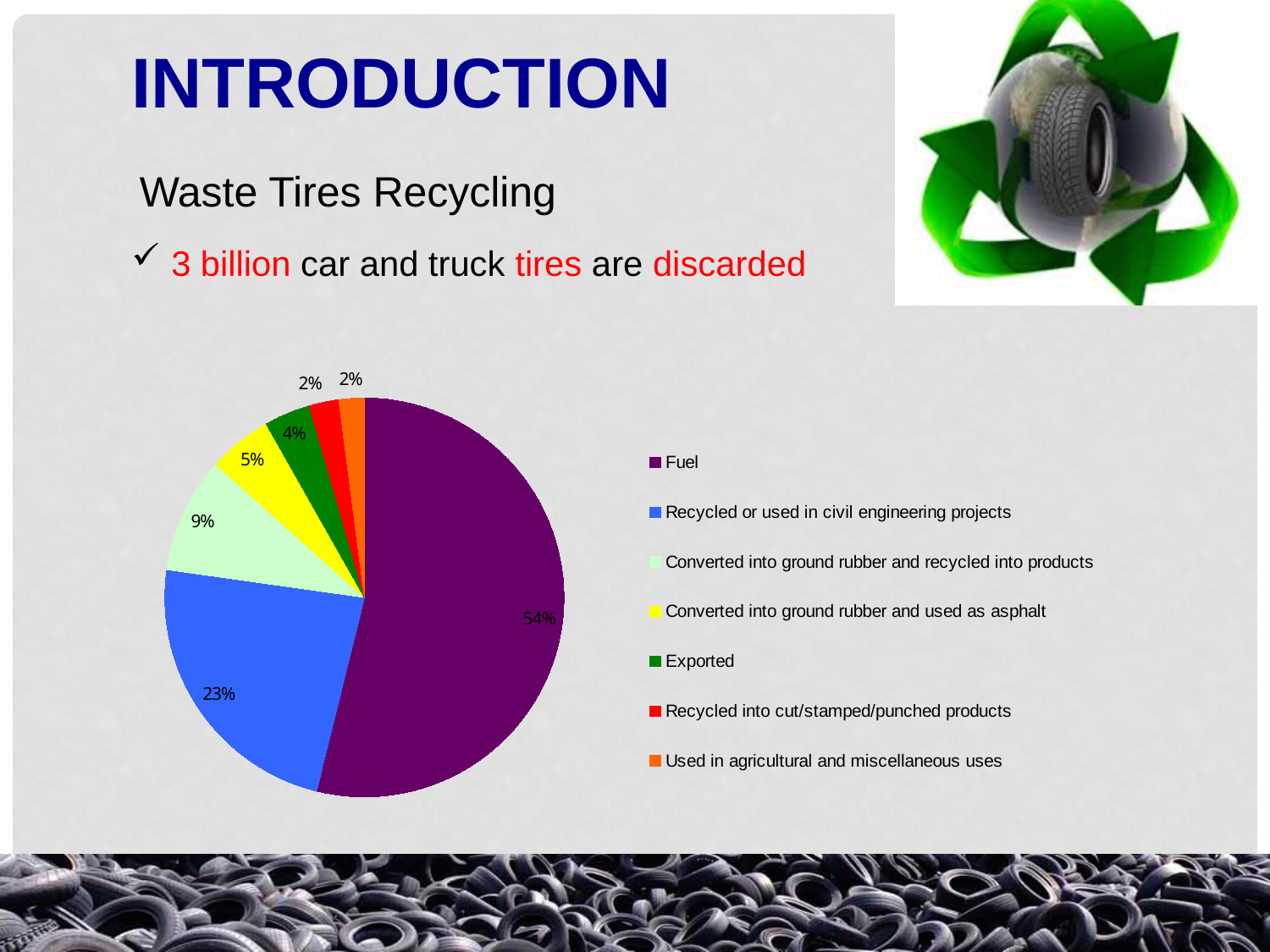
What percentage is shown for Converted into ground rubber and recycled into products? 9% Which is larger, the share for Exported or the share for Converted into ground rubber and used as asphalt? Converted into ground rubber and used as asphalt What percentage is shown for Recycled or used in civil engineering projects? 23% What colour is the Fuel slice in the pie chart? purple What is the difference in percentage points between Fuel and Recycled or used in civil engineering projects? 31 What kind of chart is shown on the slide? pie chart Which category has the largest slice of the pie? Fuel Which legend entry is shown in orange? Used in agricultural and miscellaneous uses How many categories does the legend list? 7 What share of the pie does Fuel account for? 54% What percentage is shown for Converted into ground rubber and used as asphalt? 5% What percentage is shown for Exported? 4%